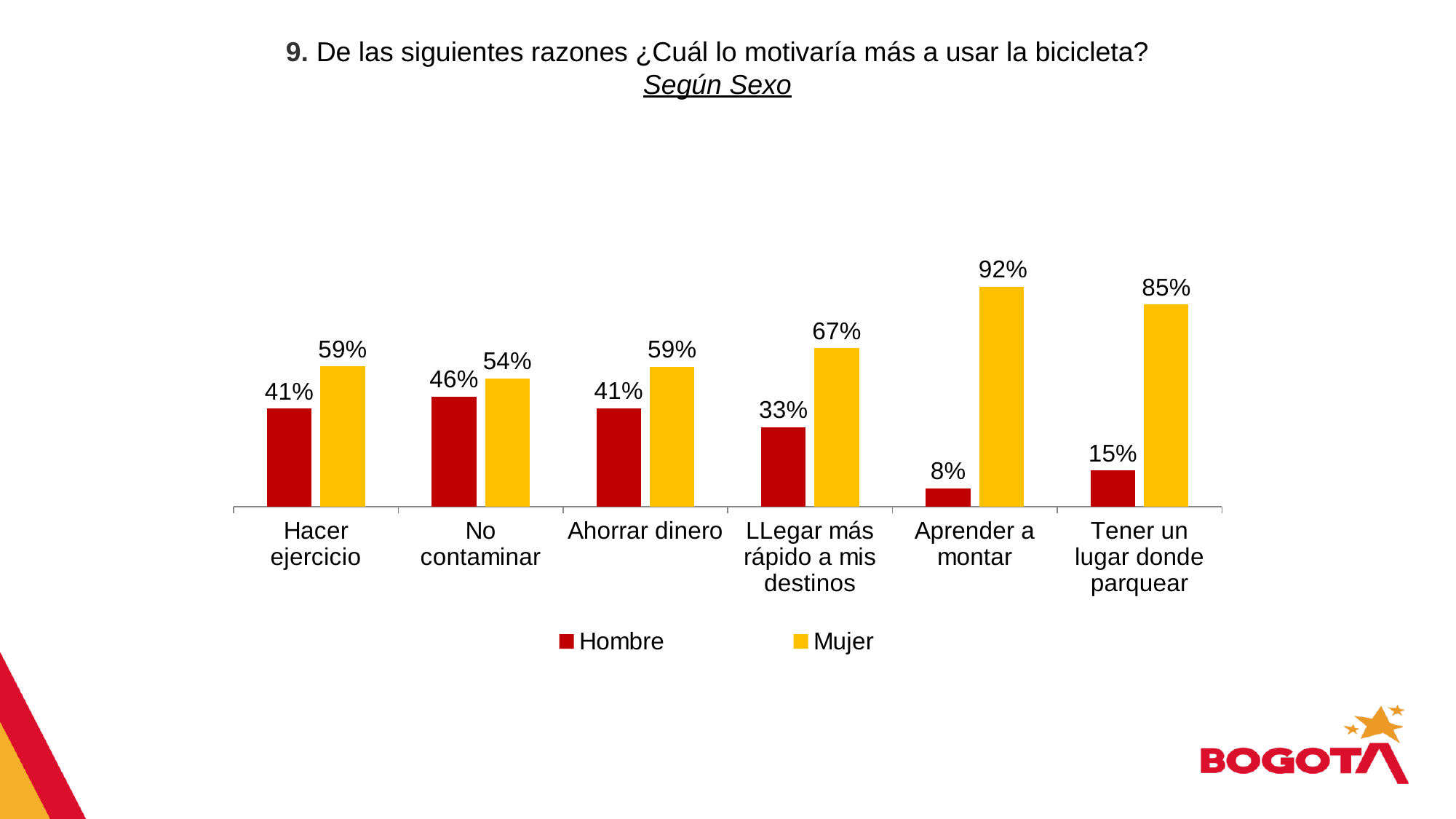
What is the value for Mujer in the 'Aprender a montar' category? 92% What is the difference between the Mujer and Hombre values for 'LLegar más rápido a mis destinos'? 34% Which colour represents the Mujer series? Yellow What is the value for Hombre in the 'No contaminar' category? 46% What is the value for Hombre in the 'Tener un lugar donde parquear' category? 15% How many categories are shown on the x axis? 6 Which category has the lowest value for Hombre? Aprender a montar What is the difference between the Mujer and Hombre values for 'Aprender a montar'? 84% How many series does the legend list? 2 Which is larger, the Hombre value for 'No contaminar' or the Hombre value for 'Hacer ejercicio'? No contaminar Which category has the highest value for Mujer? Aprender a montar What kind of chart is shown on the slide? Bar chart